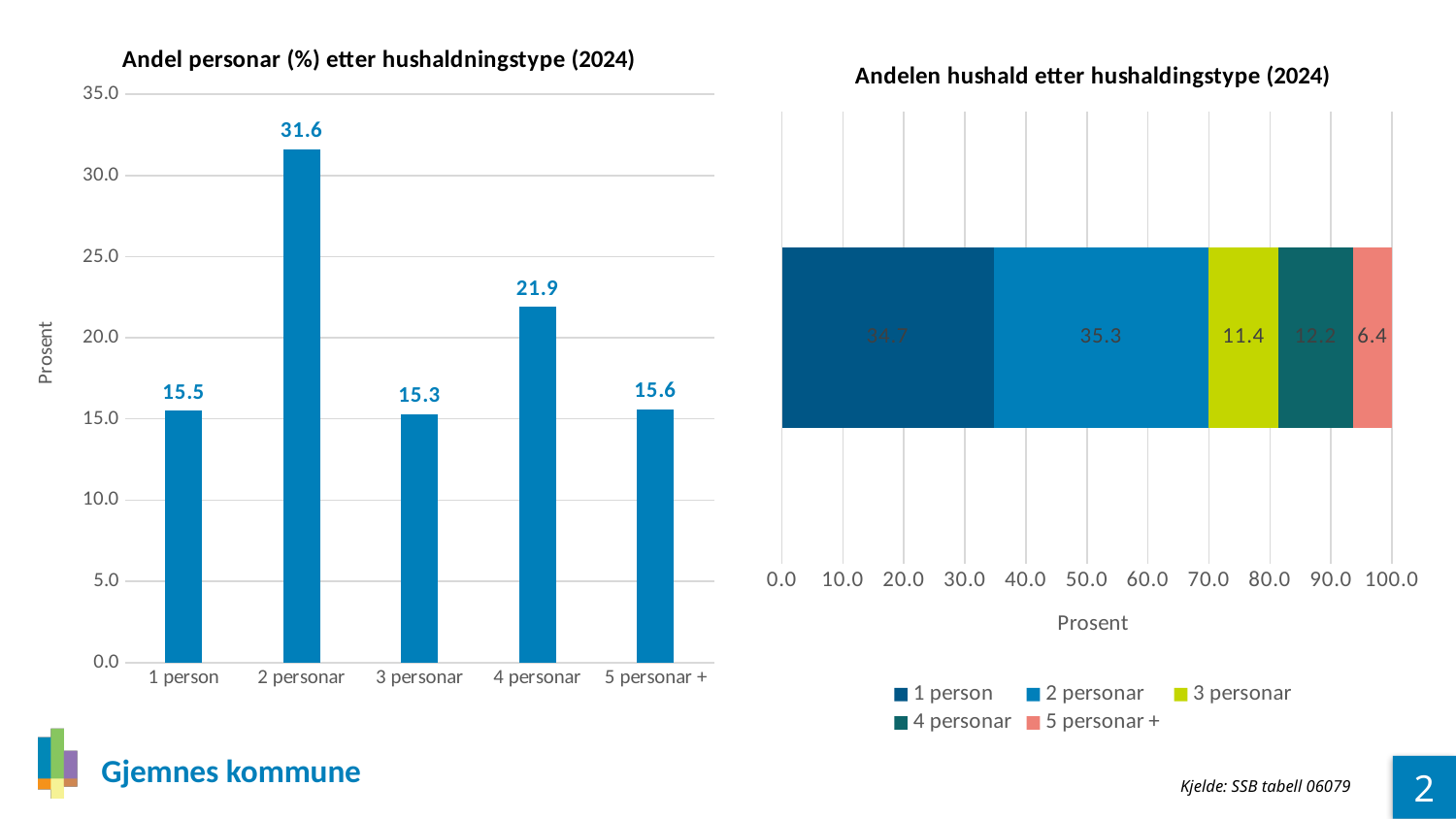
In the chart 'Andel personar (%) etter hushaldningstype (2024)', which category has the highest value? 2 personar How many series does the legend of the chart 'Andelen hushald etter hushaldingstype (2024)' list? 5 In the chart 'Andelen hushald etter hushaldingstype (2024)', which is larger, the value for 3 personar or the value for 5 personar +? 3 personar In the chart 'Andel personar (%) etter hushaldningstype (2024)', what is the difference between the values for 2 personar and 4 personar? 9.7 What is the axis title on the horizontal axis of the chart 'Andelen hushald etter hushaldingstype (2024)'? Prosent In the chart 'Andel personar (%) etter hushaldningstype (2024)', what is the value for 4 personar? 21.9 In the chart 'Andel personar (%) etter hushaldningstype (2024)', what is the value for 2 personar? 31.6 What kind of chart is 'Andel personar (%) etter hushaldningstype (2024)'? bar chart In the chart 'Andel personar (%) etter hushaldningstype (2024)', how many categories are shown on the x axis? 5 In the chart 'Andelen hushald etter hushaldingstype (2024)', what is the value for 2 personar? 35.3 In the chart 'Andel personar (%) etter hushaldningstype (2024)', which category has the lowest value? 3 personar In the chart 'Andelen hushald etter hushaldingstype (2024)', what is the value for 5 personar +? 6.4